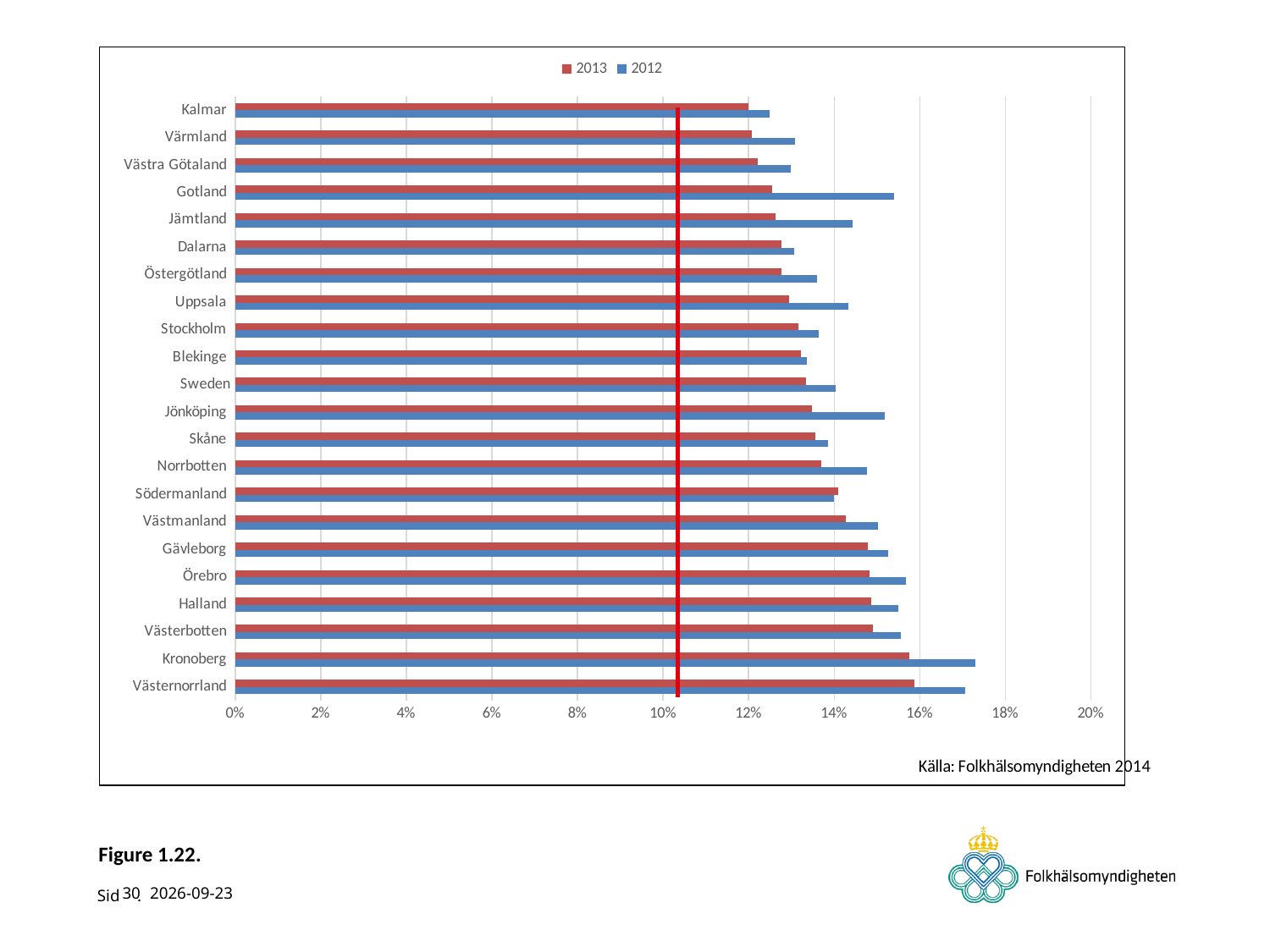
How many series does the legend list? 2 Which is larger, the 2012 value for Jönköping or the 2012 value for Skåne? Jönköping What kind of chart is shown on the slide? bar chart Which years are listed in the legend? 2013 and 2012 Is the 2012 value for Kronoberg greater or less than 16%? greater What source is cited below the chart? Källa: Folkhälsomyndigheten 2014 Is the 2012 value for Gotland greater or less than 14%? greater Is the 2013 value for Gotland greater or less than 14%? less For Gotland, which is larger, the 2012 value or the 2013 value? 2012 Which category has the lowest value for 2012? Kalmar How many categories are plotted on the y axis? 22